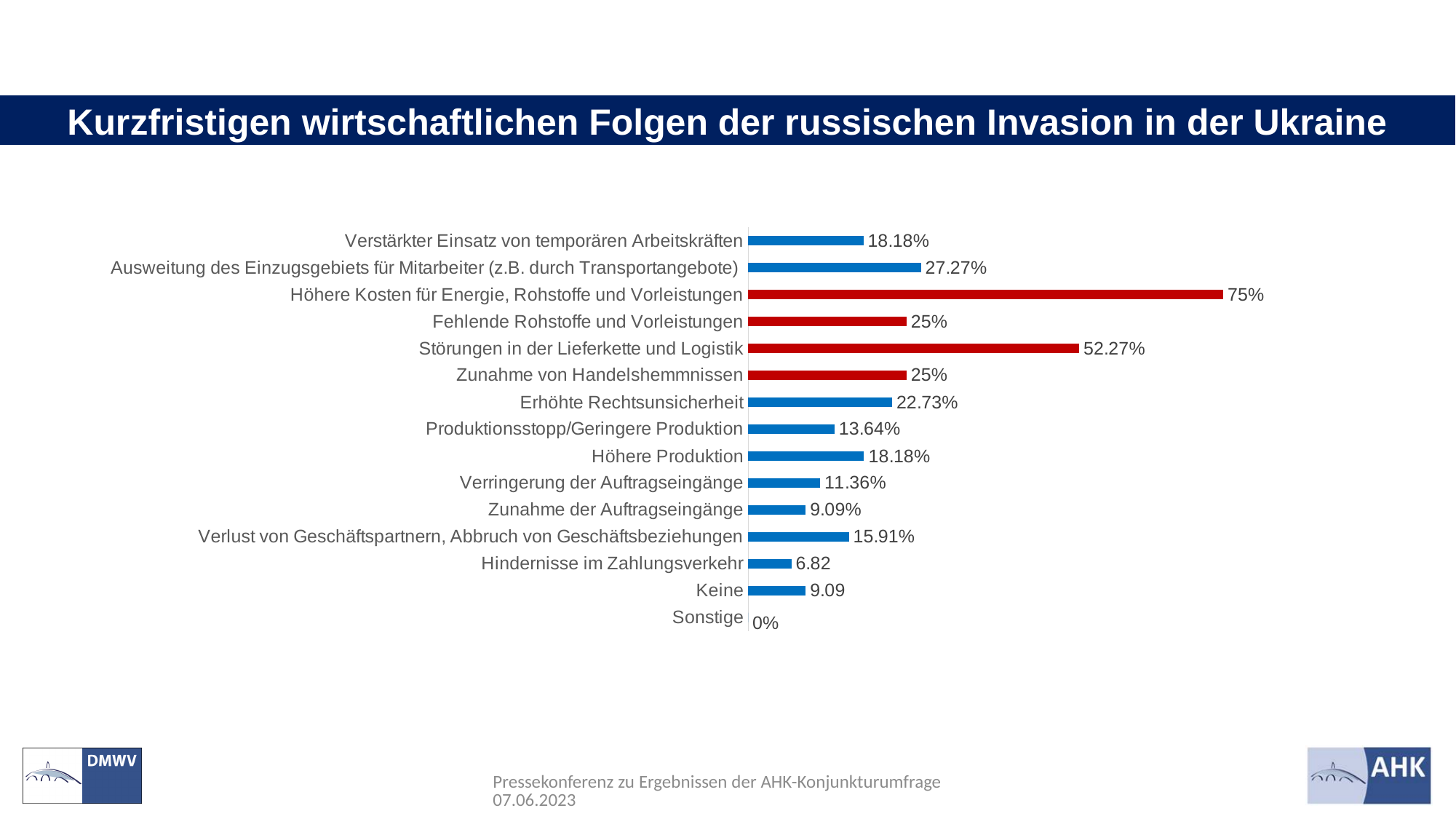
How many bars in the chart are coloured red? 4 What is the value for "Hindernisse im Zahlungsverkehr"? 6.82 How many categories are shown in the chart? 15 What is the value for "Erhöhte Rechtsunsicherheit"? 22.73% What is the value for "Höhere Kosten für Energie, Rohstoffe und Vorleistungen"? 75% What is the difference between the values for "Höhere Kosten für Energie, Rohstoffe und Vorleistungen" and "Störungen in der Lieferkette und Logistik"? 22.73% What is the title of the slide? Kurzfristigen wirtschaftlichen Folgen der russischen Invasion in der Ukraine What is the value for "Störungen in der Lieferkette und Logistik"? 52.27% What kind of chart is shown on the slide? bar chart Which category has the lowest value? Sonstige Which category has the highest value? Höhere Kosten für Energie, Rohstoffe und Vorleistungen Which is larger: the value for "Ausweitung des Einzugsgebiets für Mitarbeiter (z.B. durch Transportangebote)" or the value for "Erhöhte Rechtsunsicherheit"? Ausweitung des Einzugsgebiets für Mitarbeiter (z.B. durch Transportangebote)